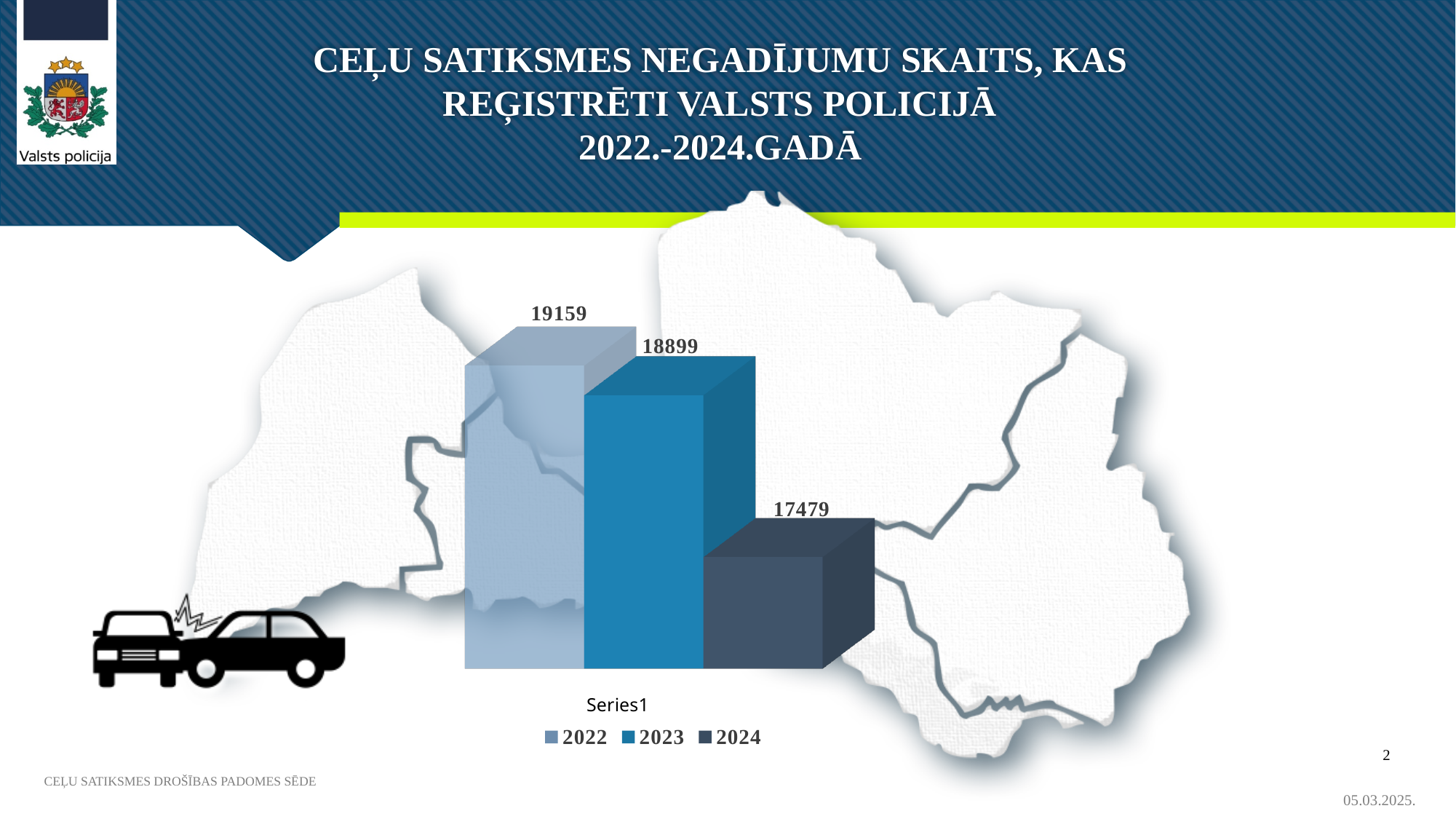
What is the difference between the values for 2022 and 2024? 1680 What is the value shown for 2022? 19159 What kind of chart is shown on the slide? Bar chart Which year has the highest value? 2022 What is the value shown for 2024? 17479 Do the values rise or fall from 2022 to 2024? Fall Which year has the lowest value? 2024 Which is larger, the value for 2023 or the value for 2024? 2023 What is the value shown for 2023? 18899 What is the difference between the values for 2022 and 2023? 260 What is the difference between the values for 2023 and 2024? 1420 How many series does the legend list? 3